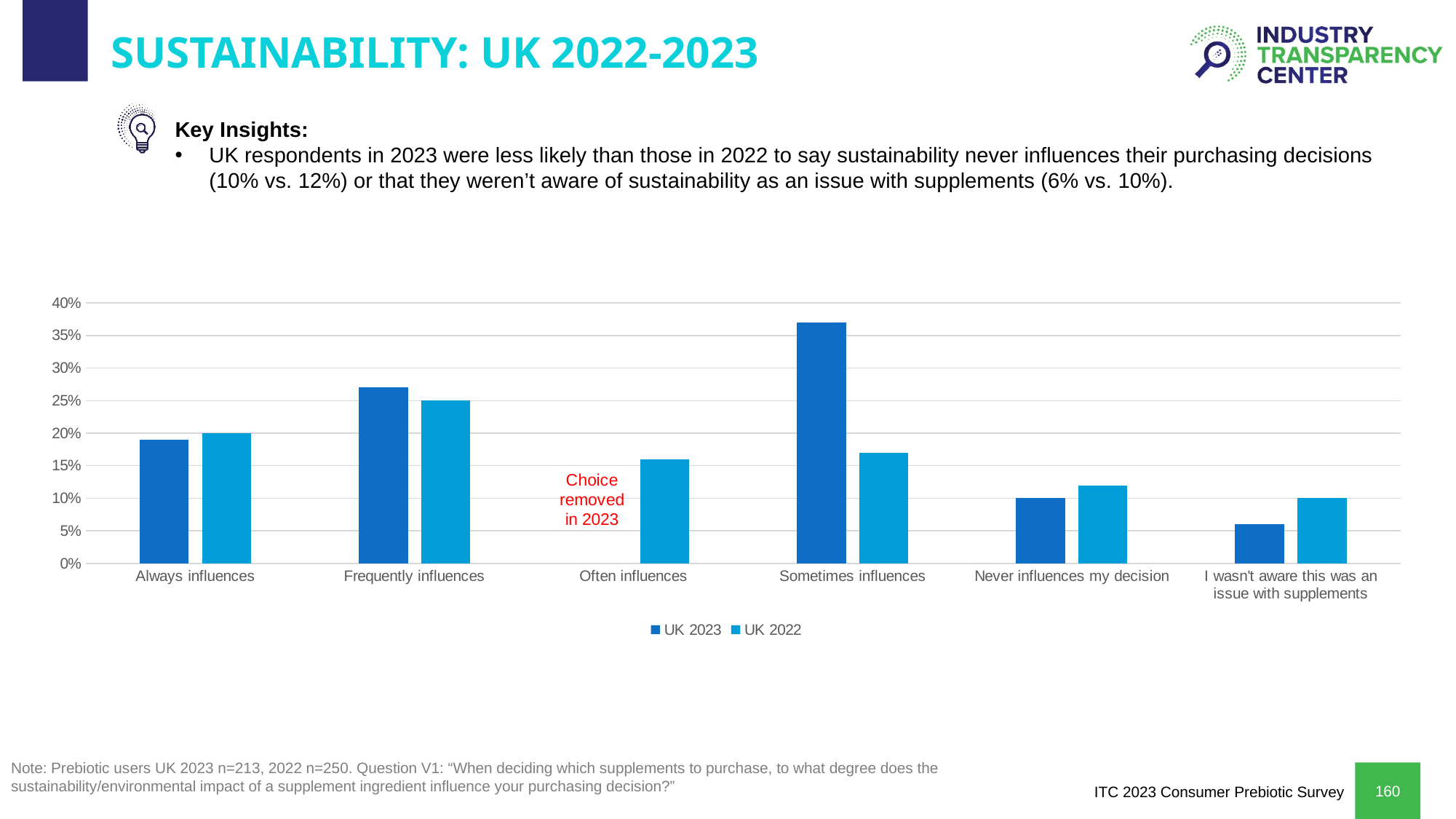
Is the UK 2023 value for 'Sometimes influences' greater or less than 35%? greater What is the UK 2023 value for 'Never influences my decision'? 10% Which category has the lowest value for UK 2023? I wasn't aware this was an issue with supplements Which category has the highest value for UK 2023? Sometimes influences How many series does the legend list? 2 Which category has no UK 2023 bar because the choice was removed in 2023? Often influences Is the UK 2022 value for 'Often influences' greater or less than 20%? less For 'Sometimes influences', which series has the larger value, UK 2023 or UK 2022? UK 2023 What is the difference between the UK 2022 and UK 2023 values for 'Never influences my decision'? 2 percentage points What kind of chart is shown on the slide? Bar chart How many categories are shown on the x axis of the chart? 6 What is the UK 2022 value for 'I wasn't aware this was an issue with supplements'? 10%